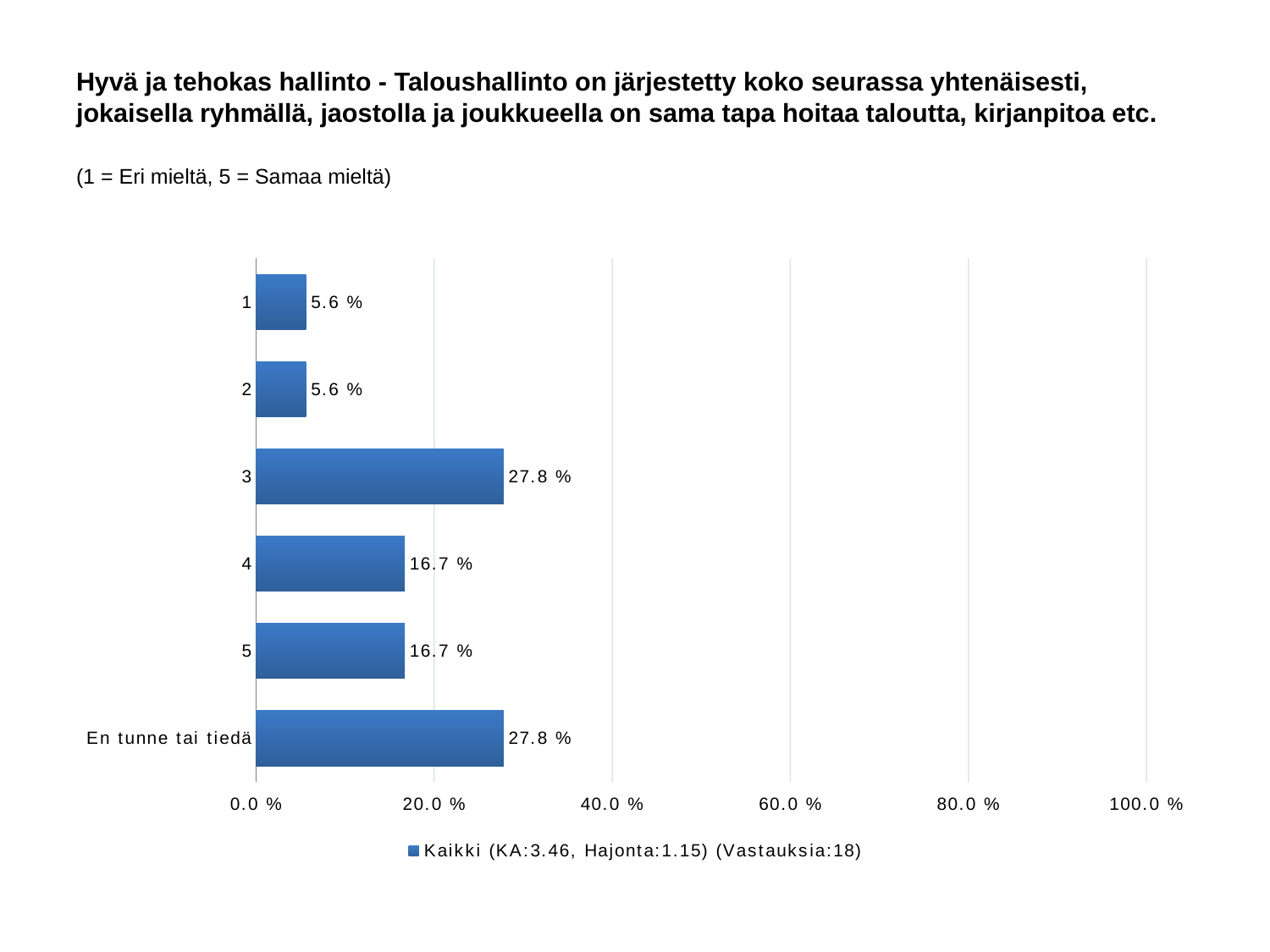
What is the value for category 1? 5.6 % What is the value for category 4? 16.7 % Which has the larger value, category 2 or category 4? 4 Which has the larger value, category 3 or category 5? 3 What is the difference between the values for "En tunne tai tiedä" and category 2? 22.2 % What is the value for "En tunne tai tiedä"? 27.8 % What is the highest value shown in the chart? 27.8 % What is the value for category 3? 27.8 % How many categories are shown on the chart? 6 Is the value for category 3 greater or less than 20.0 %? greater What is the difference between the values for category 3 and category 4? 11.1 % How many series does the legend list? 1